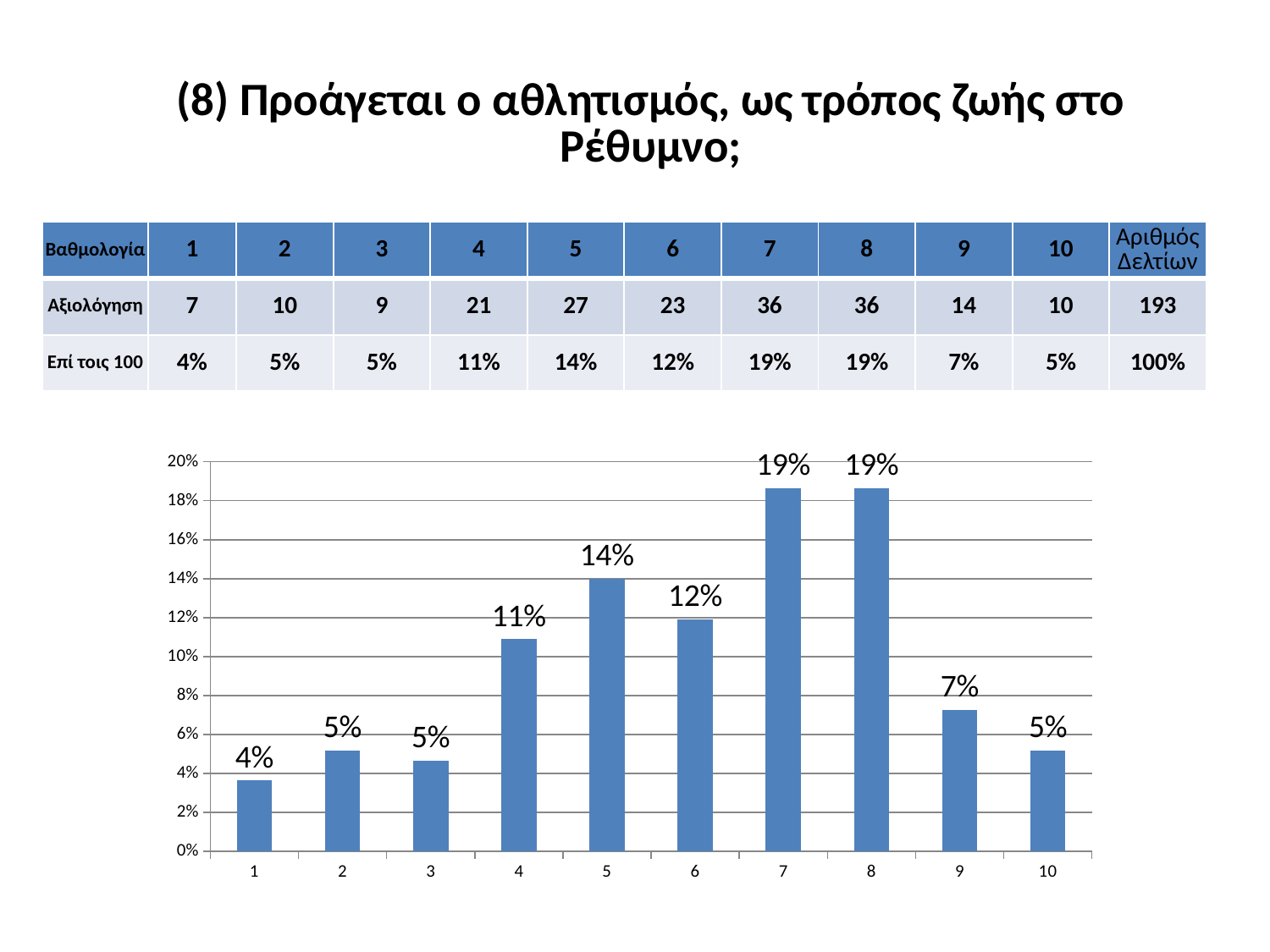
What is the difference between the values for category 7 and category 4? 8% Which is larger, the value for category 9 or the value for category 4? category 4 What kind of chart is shown on the slide? bar chart What is the value shown for category 5 in the bar chart? 14% Do the values rise or fall from category 8 to category 10? fall What is the difference between the values for category 6 and category 10? 7% Is the value for category 7 greater or less than 18%? greater What is the value shown for category 9 in the bar chart? 7% What is the value shown for category 1 in the bar chart? 4% How many categories are shown on the x axis of the bar chart? 10 Which category has the lowest value in the bar chart? 1 Which is larger, the value for category 5 or the value for category 6? category 5